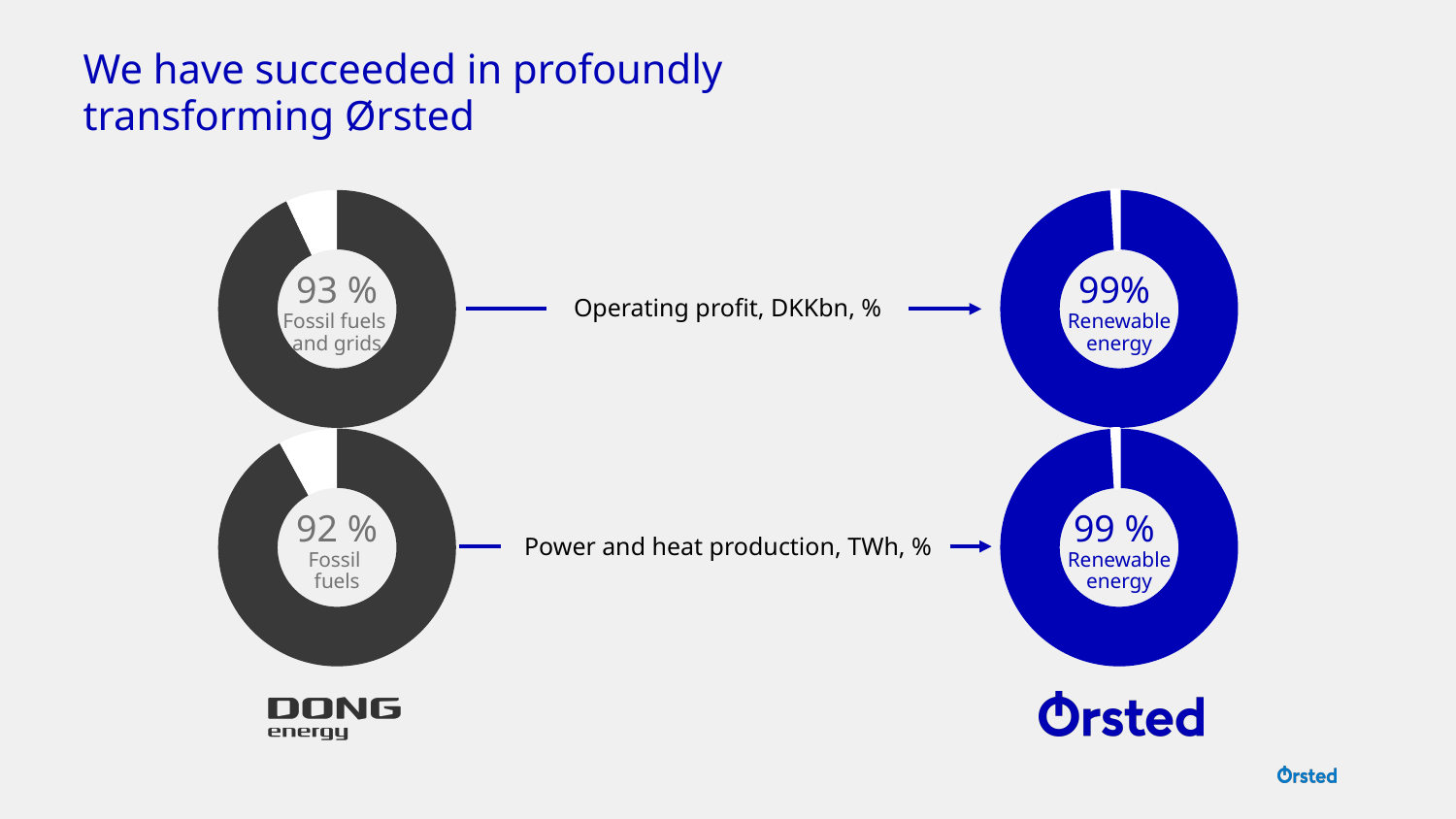
In the bottom-left donut chart (DONG energy, power and heat production), what share is labelled for fossil fuels? 92 % In the top-right donut chart (Ørsted, operating profit), what share is labelled for renewable energy? 99% Which metric does the top row of donut charts describe? Operating profit, DKKbn, % Which metric does the bottom row of donut charts describe? Power and heat production, TWh, % How many donut charts are shown on the slide? 4 In the bottom-left donut chart, is the fossil fuels share greater or less than 90%? greater In the top-left donut chart (DONG energy, operating profit), what share is labelled for fossil fuels and grids? 93 % In the bottom-right donut chart (Ørsted, power and heat production), what share is labelled for renewable energy? 99 % What kind of chart is used for the four charts on the slide? Donut (pie) chart Which is larger: the fossil fuels and grids share in the top-left chart or the fossil fuels share in the bottom-left chart? Fossil fuels and grids (top-left, 93 %) What is the difference between the fossil fuels and grids share in the top-left chart (93 %) and the fossil fuels share in the bottom-left chart (92 %)? 1 percentage point What is the difference between the renewable energy share in the top-right chart (99%) and the fossil fuels and grids share in the top-left chart (93 %)? 6 percentage points